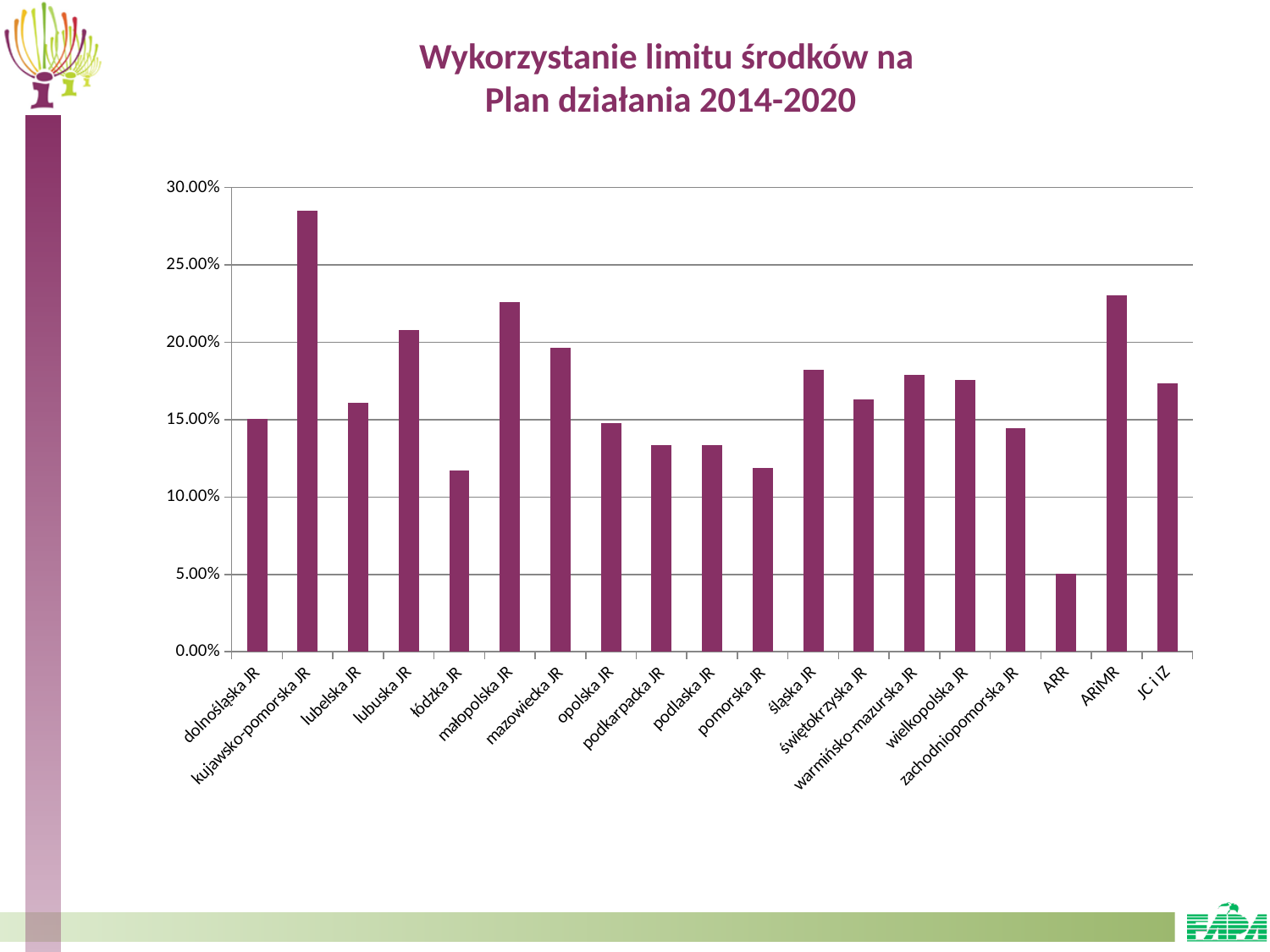
How many categories are shown on the x axis of the chart? 19 Is the value for łódzka JR greater or less than 15.00%? less What is the title of the chart? Wykorzystanie limitu środków na Plan działania 2014-2020 Which has the larger value, lubuska JR or lubelska JR? lubuska JR Is the value for ARR greater or less than 10.00%? less What kind of chart is shown on the slide? bar chart Is the value for ARiMR greater or less than 20.00%? greater Which category has the highest value in the chart? kujawsko-pomorska JR Which has the larger value, pomorska JR or śląska JR? śląska JR Which category has the lowest value in the chart? ARR